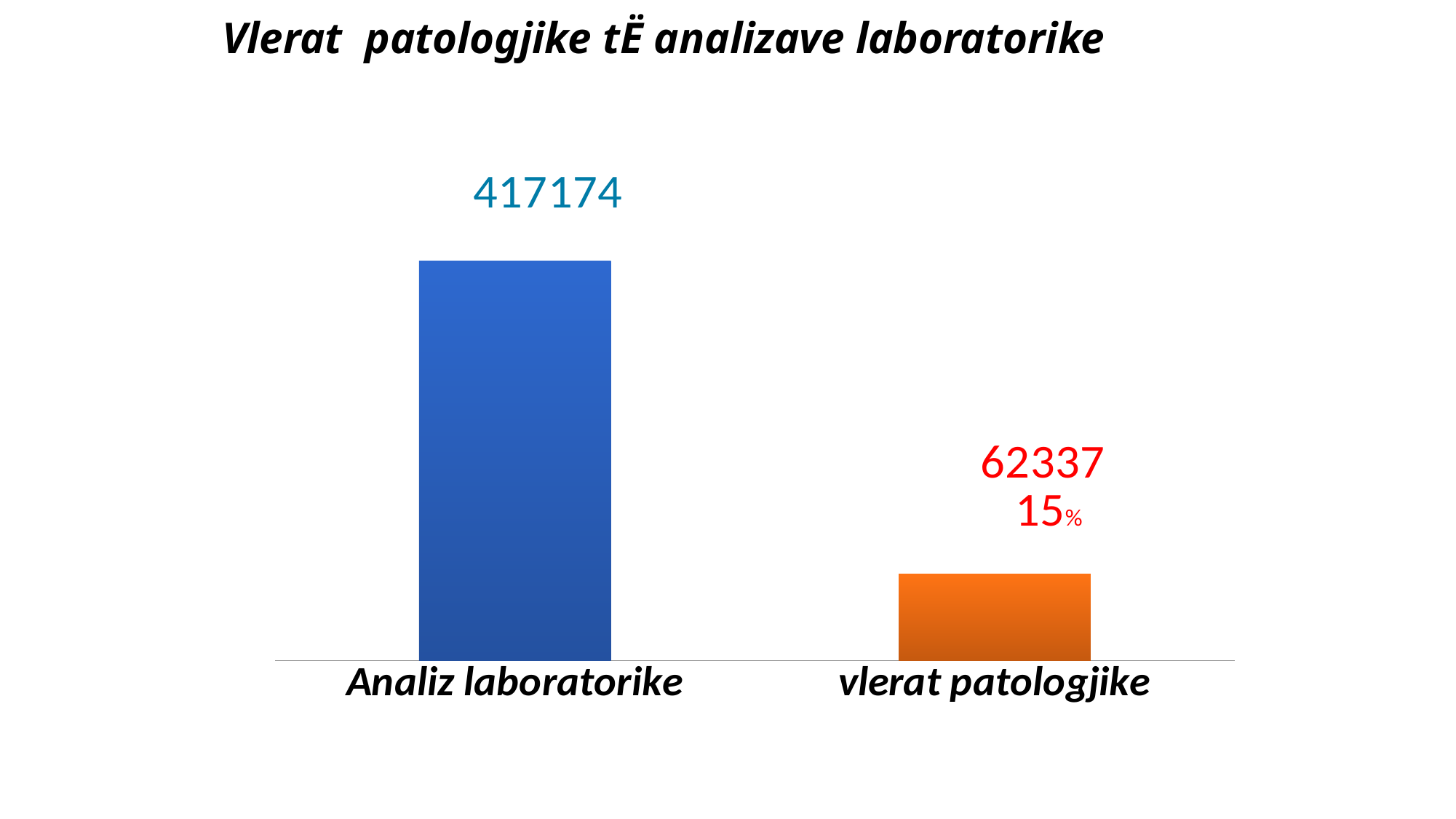
What is the title of the chart? Vlerat patologjike tË analizave laboratorike Which category has the highest value? Analiz laboratorike What is the difference between the values for Analiz laboratorike and vlerat patologjike? 354837 What kind of chart is shown on the slide? Bar chart What percentage is shown above the vlerat patologjike bar? 15% What is the value for Analiz laboratorike? 417174 What is the value for vlerat patologjike? 62337 How many categories are shown in the chart? 2 Which is larger, the value for Analiz laboratorike or the value for vlerat patologjike? Analiz laboratorike Which category has the lowest value? vlerat patologjike What colour is the bar for vlerat patologjike? Orange